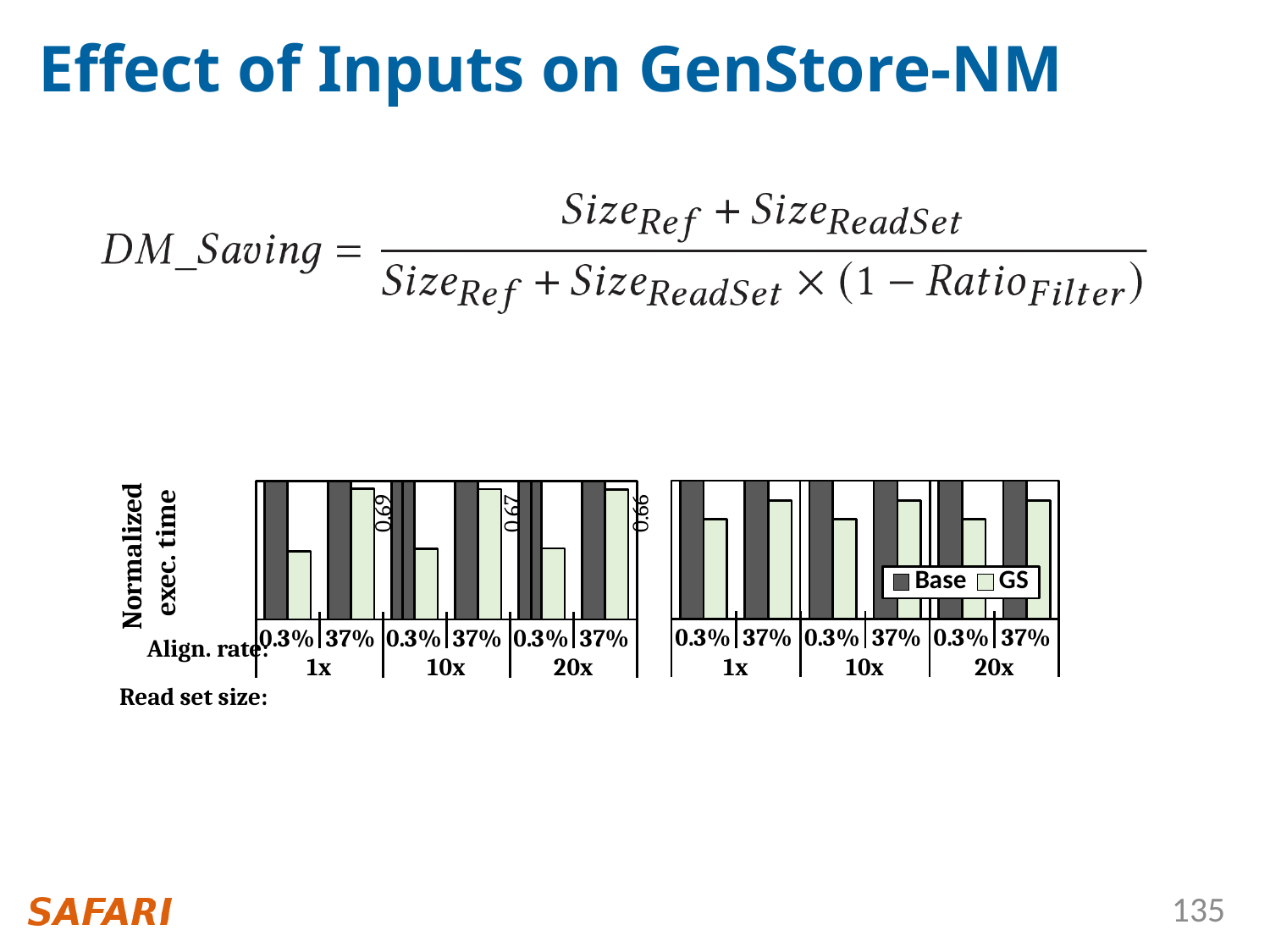
In the left chart, what is the normalized exec. time for GS at 37% align rate with a 10x read set size? 0.67 What type of chart is shown on the slide? bar chart How many align rate / read set size category groups does each chart show? 6 What is the y-axis label of the charts? Normalized exec. time In the left chart, at 0.3% align rate with a 1x read set size, which is larger: Base or GS? Base What are the two series named in the legend? Base and GS How many series does the legend list? 2 In the left chart, among the labeled GS bars at 37% align rate, which read set size has the lowest value? 20x In the left chart, what is the normalized exec. time for GS at 37% align rate with a 20x read set size? 0.66 In the left chart, what is the normalized exec. time for GS at 37% align rate with a 1x read set size? 0.69 In the left chart, what is the difference between the GS values at 37% align rate for 1x and 20x read set sizes? 0.03 In the left chart, do the labeled GS values at 37% align rate rise or fall as the read set size increases from 1x to 20x? fall